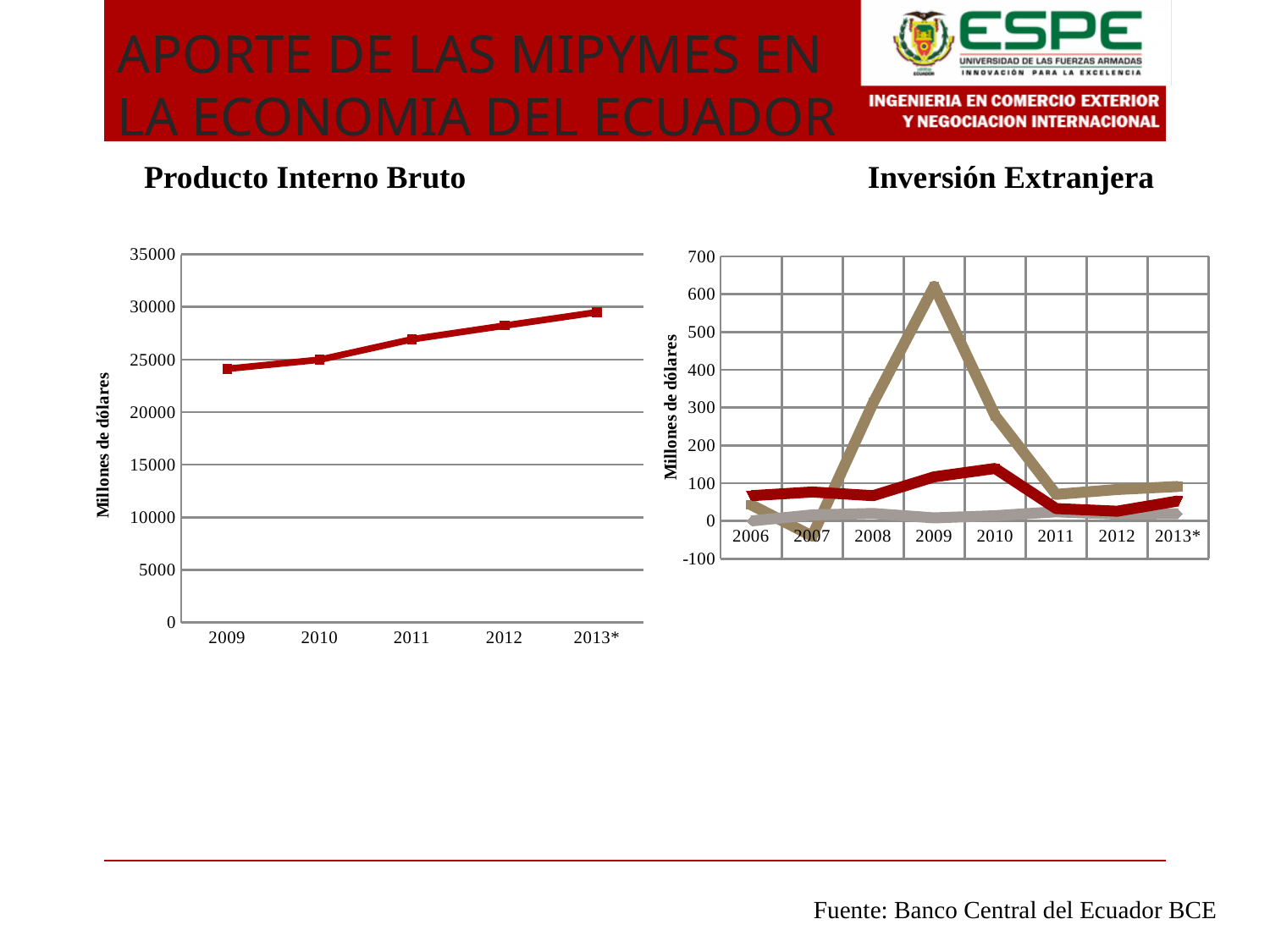
What is the y-axis label of the Inversión Extranjera chart? Millones de dólares How many years are shown on the x axis of the Inversión Extranjera chart? 8 In the Producto Interno Bruto chart, which year has the lowest value? 2009 In the Inversión Extranjera chart, in which year does the tan (light brown) line reach its highest value? 2009 In the Producto Interno Bruto chart, is the value for 2013* greater or less than 25000? greater How many years are shown on the x axis of the Producto Interno Bruto chart? 5 What kind of chart is the Producto Interno Bruto chart? line chart In the Producto Interno Bruto chart, is the value for 2009 greater or less than 20000? greater In the Inversión Extranjera chart, is the peak value of the tan line in 2009 greater or less than 500? greater What kind of chart is the Inversión Extranjera chart? line chart In the Producto Interno Bruto chart, which year has the highest value? 2013* In the Producto Interno Bruto chart, do the values rise or fall from 2009 to 2013*? rise